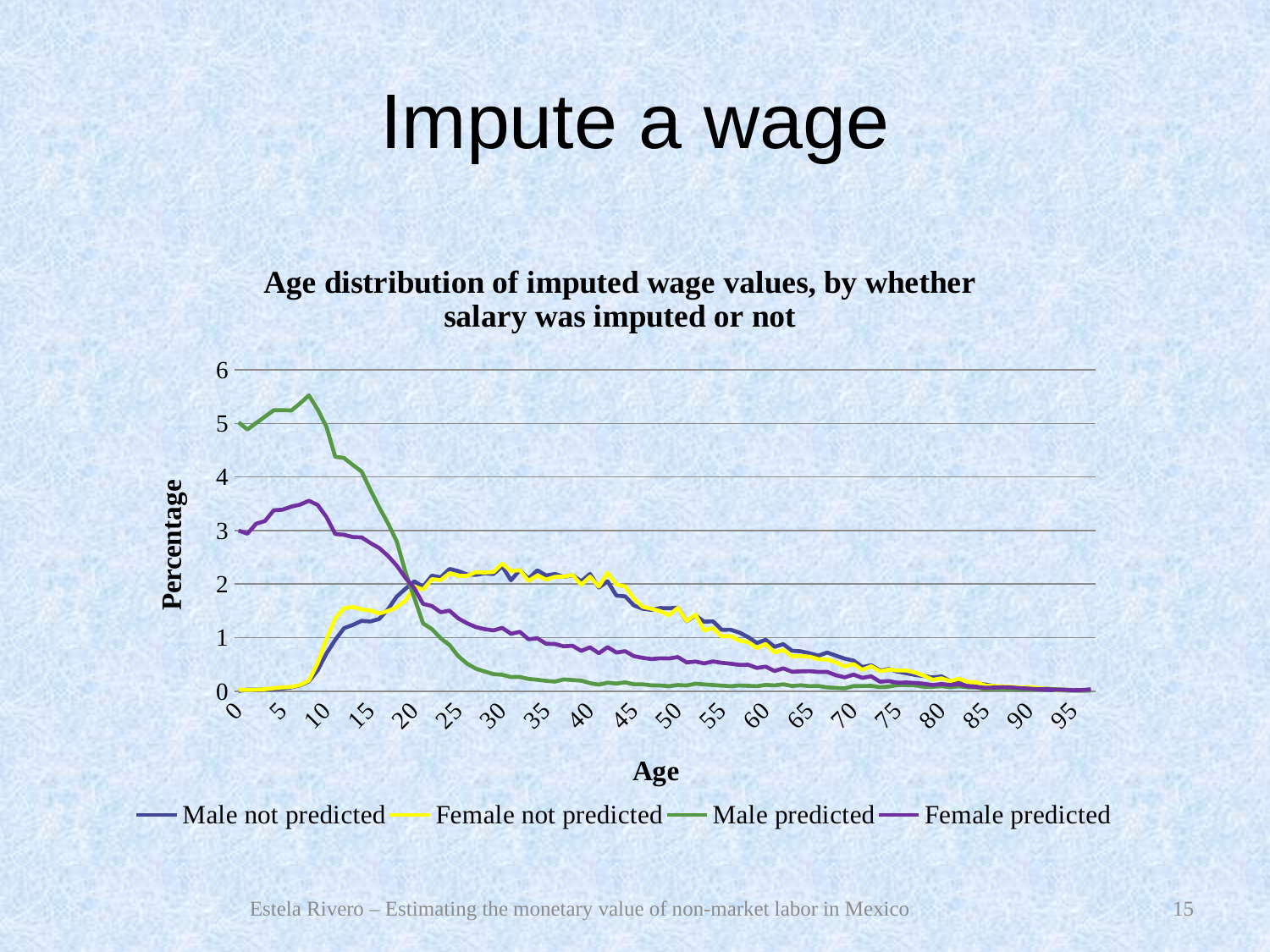
At age 30, which is larger: Male not predicted or Male predicted? Male not predicted Is the value for Male not predicted at age 0 greater or less than 1? less Is the value for Male predicted at age 15 greater or less than 3? greater At age 5, which is larger: Male predicted or Female predicted? Male predicted Is the value for Female not predicted at age 15 greater or less than 1? greater How many series does the legend list? 4 Does the Male predicted series rise or fall from age 10 to age 95? fall What kind of chart is shown on the slide? line chart What is the title of the chart? Age distribution of imputed wage values, by whether salary was imputed or not Which series reaches the highest value on the chart? Male predicted What is the label of the vertical axis? Percentage